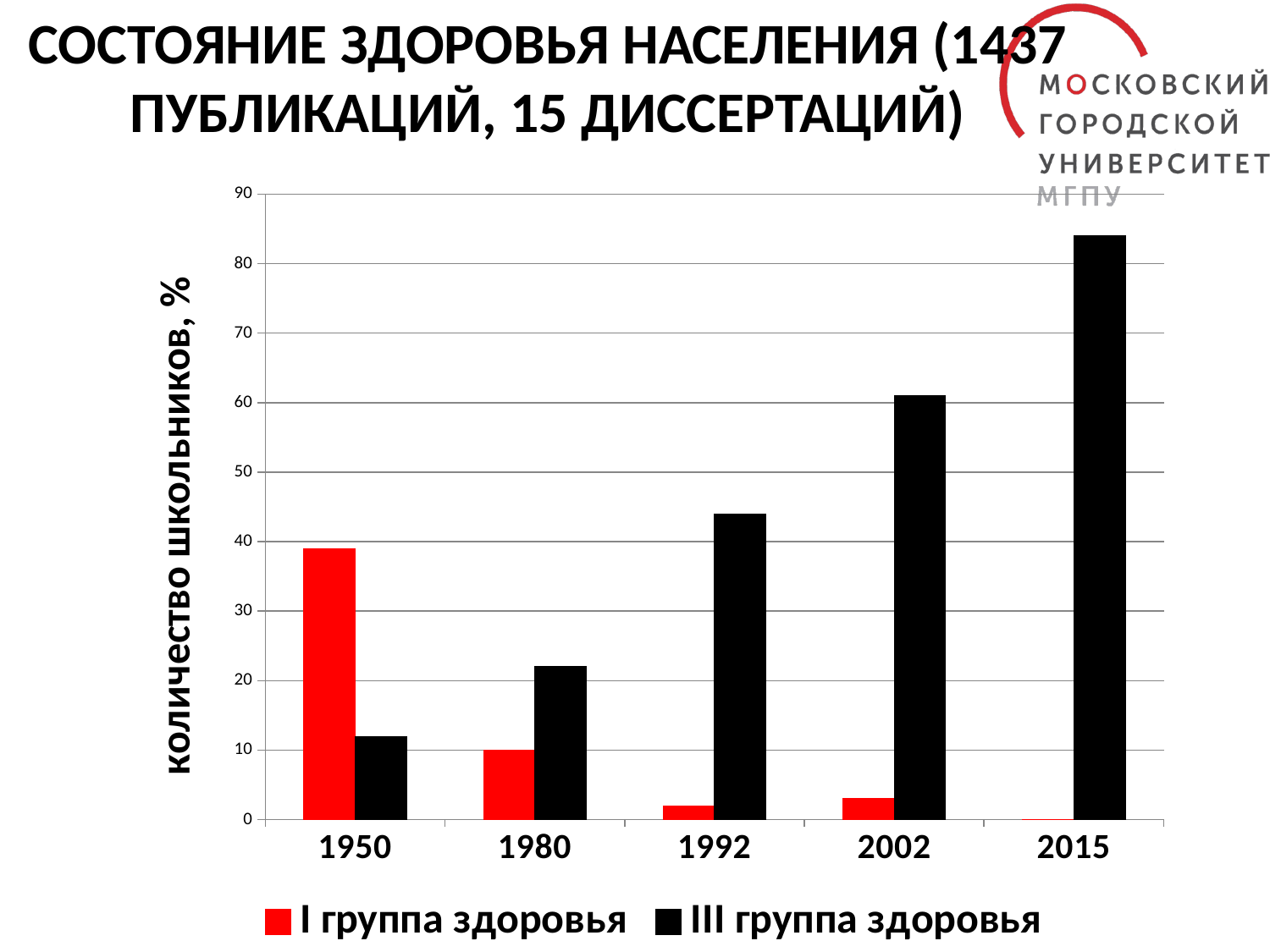
How many series does the chart legend list? 2 How many years are shown on the x axis of the chart? 5 What is the label of the vertical axis of the chart? количество школьников, % Does the value for III группа здоровья rise or fall from 1950 to 2015? rise Is the value for III группа здоровья in 2002 greater or less than 70? less Is the value for III группа здоровья in 2015 greater or less than 80? greater In which year is the value for I группа здоровья highest? 1950 What kind of chart is shown on the slide? bar chart In 1950, which series has the larger value: I группа здоровья or III группа здоровья? I группа здоровья In which year is the value for III группа здоровья lowest? 1950 Is the value for I группа здоровья in 1950 greater or less than 30? greater In which year is the value for III группа здоровья highest? 2015